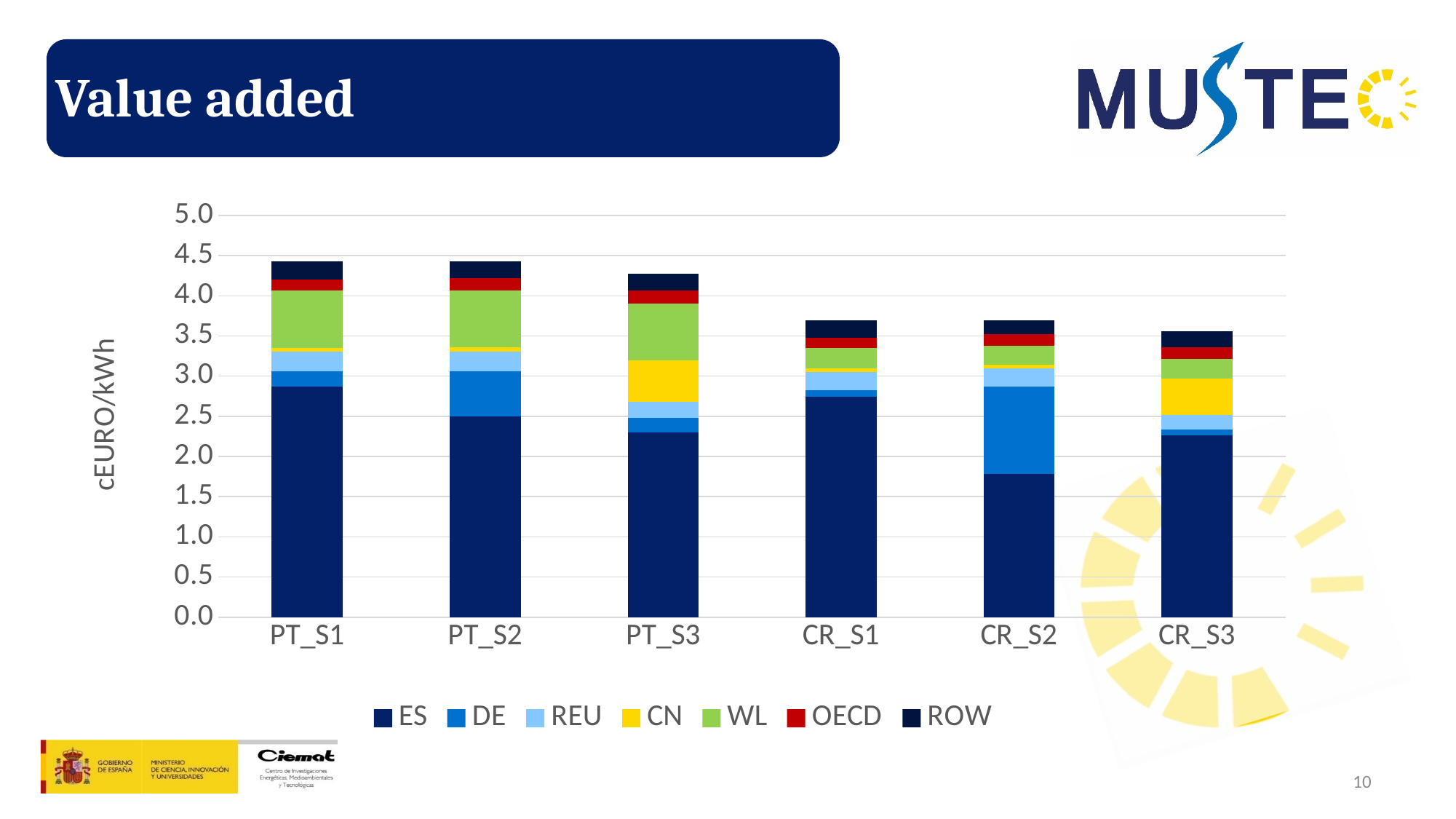
Is the ES segment for CR_S2 greater or less than 2.0? less Is the total value for CR_S3 greater or less than 4.0? less What is the label on the y axis of the chart? cEURO/kWh Which category has the lowest total bar height? CR_S3 Which has the larger total bar, PT_S3 or CR_S1? PT_S3 Which category has the larger DE segment, PT_S1 or CR_S2? CR_S2 How many series does the chart legend list? 7 Do the total bar heights generally rise or fall from left to right across the x axis? fall What kind of chart is shown on the slide? Stacked bar chart Is the ES segment for PT_S1 greater or less than 2.5? greater How many categories are shown on the x axis of the chart? 6